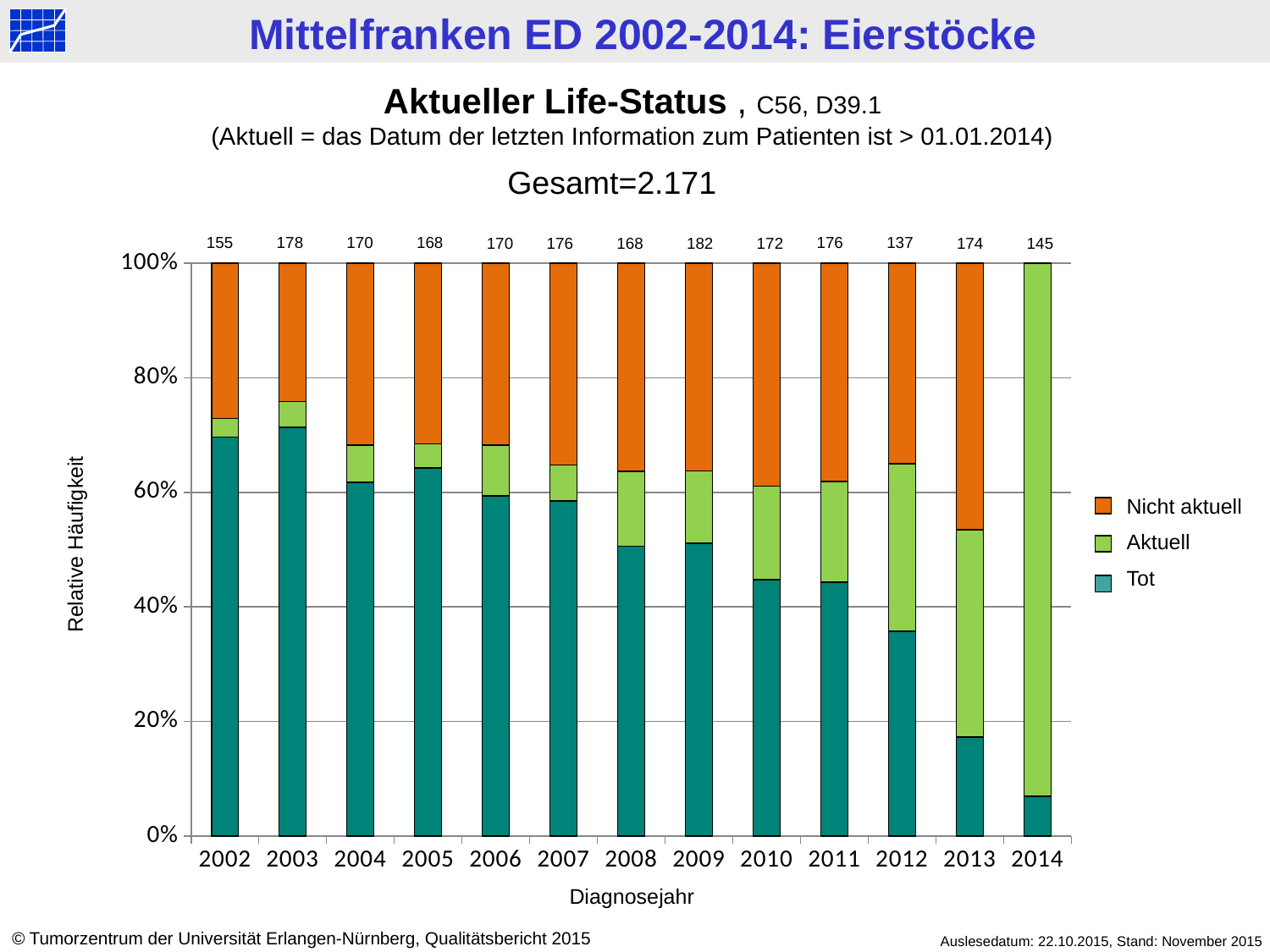
How many diagnosis years are shown on the x axis? 13 How many series does the legend list? 3 Which diagnosis year has the lowest number printed above its bar? 2012 What number is printed above the bar for 2002? 155 Is the share of 'Tot' in 2014 greater or less than 20%? less Does the share of 'Tot' rise or fall from 2002 to 2014? fall What number is printed above the bar for 2012? 137 Which diagnosis year has the highest number printed above its bar? 2009 Is the share of 'Tot' in 2002 greater or less than 60%? greater What is the difference between the numbers printed above the bars for 2009 and 2012? 45 Which year has a larger share of 'Tot': 2002 or 2010? 2002 What number is printed above the bar for 2009? 182